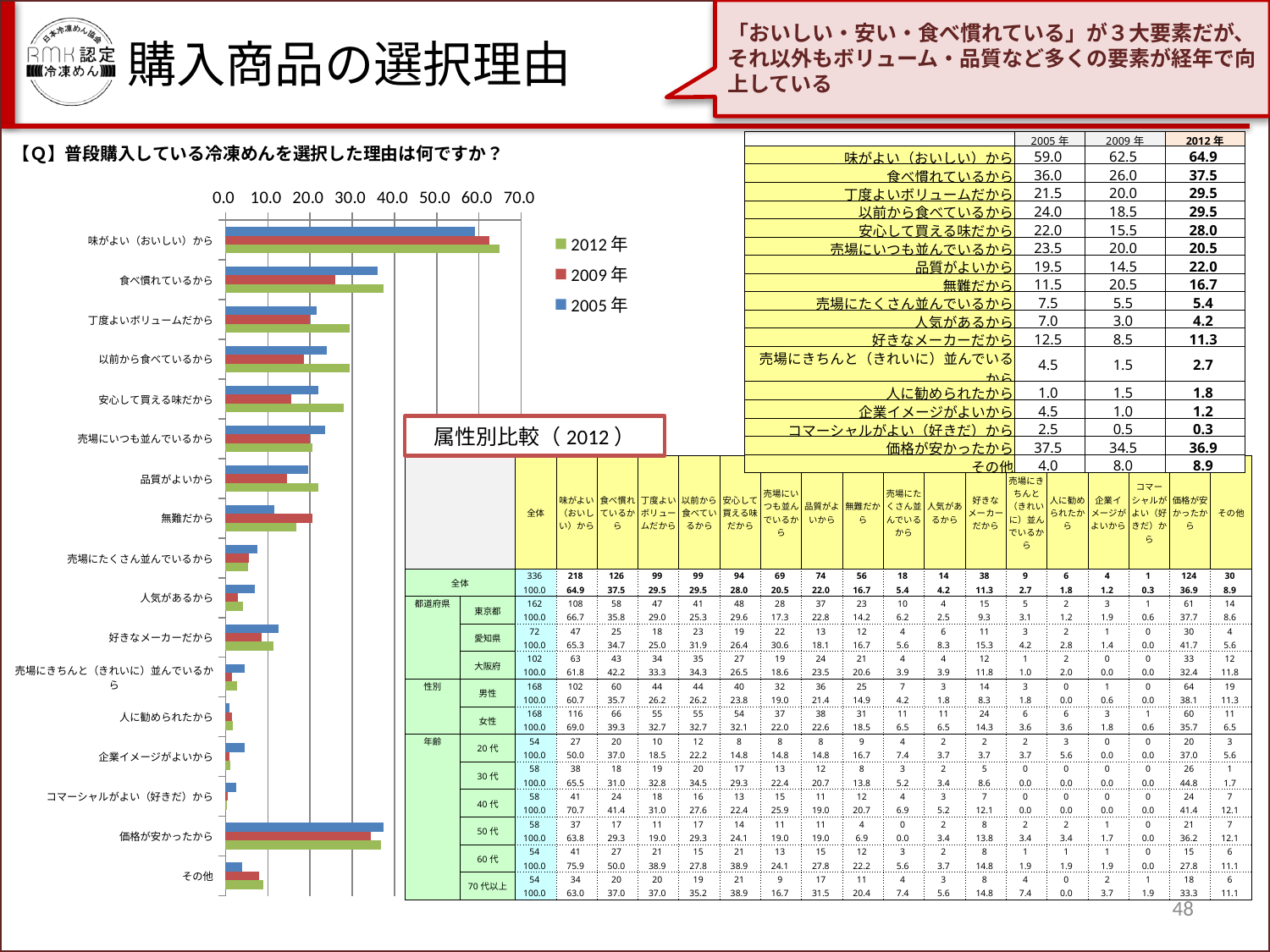
Which category has the highest 2012年 value? 味がよい（おいしい）から For 2012年, which is larger: 丁度よいボリュームだから or 品質がよいから? 丁度よいボリュームだから What kind of chart is shown on the left of the slide? bar chart How many reason categories are plotted on the bar chart? 17 According to the table, what is the 2005年 value for 価格が安かったから? 37.5 What is the difference between the 2012年 and 2005年 values for 味がよい（おいしい）から? 5.9 According to the table, what is the 2009年 value for 無難だから? 20.5 Which colour represents the 2012年 series in the bar chart? green Which category has the lowest 2012年 value? コマーシャルがよい（好きだ）から According to the table, what is the 2012年 value for 味がよい（おいしい）から? 64.9 Is the 2005年 bar for 価格が安かったから greater or less than 30.0? greater How many series does the legend of the bar chart list? 3